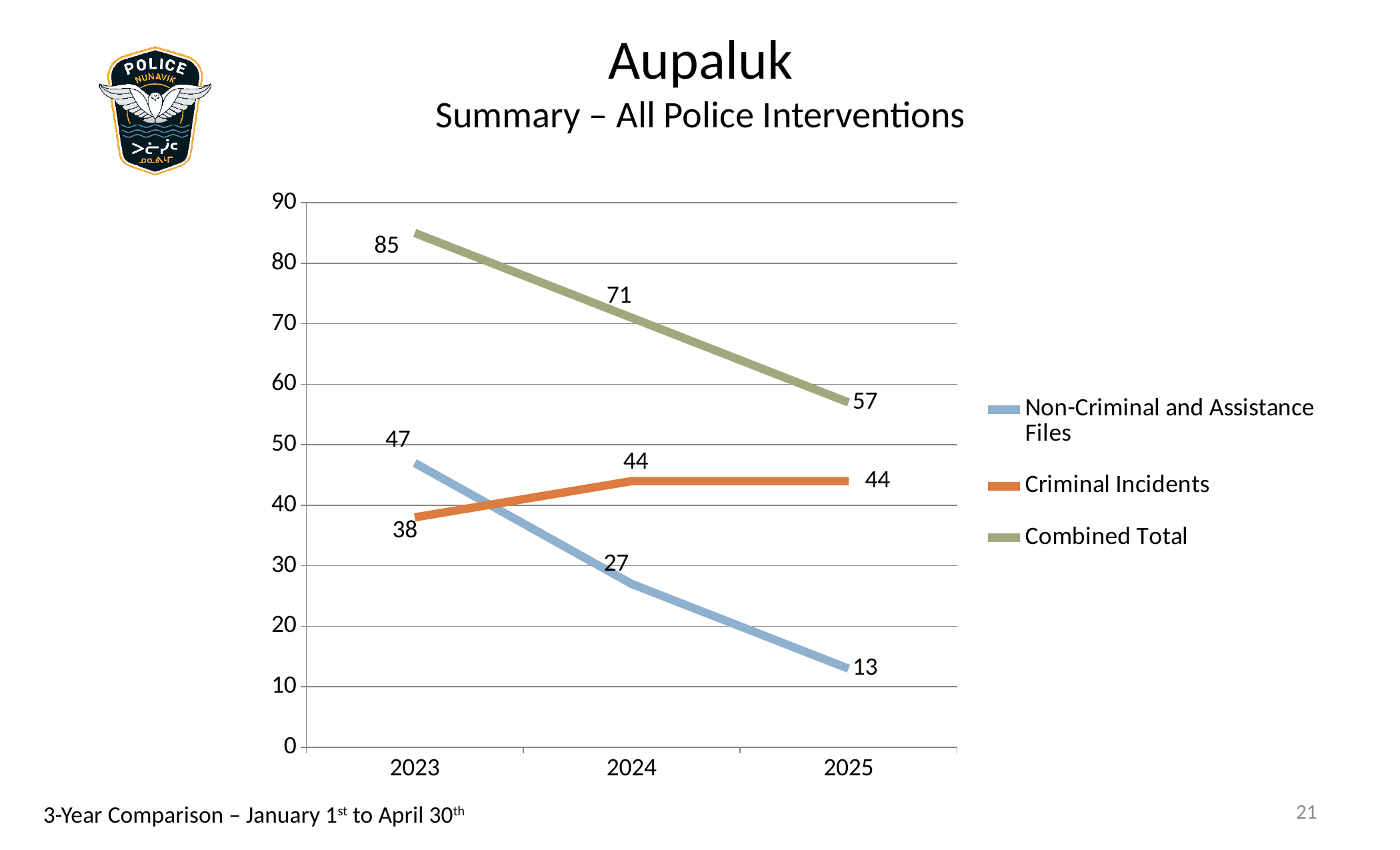
In which year is the value for Non-Criminal and Assistance Files lowest? 2025 Do the values for Non-Criminal and Assistance Files rise or fall from 2023 to 2025? Fall How many series does the legend list? 3 What kind of chart is shown on the slide? Line chart Which is larger in 2025: Criminal Incidents or Non-Criminal and Assistance Files? Criminal Incidents What is the value for Non-Criminal and Assistance Files in 2023? 47 What is the Combined Total for 2025? 57 What is the value for Criminal Incidents in 2024? 44 How many years are shown on the x axis? 3 What is the difference between the Combined Total in 2023 and in 2025? 28 In which year is the Combined Total highest? 2023 Is the Combined Total for 2024 greater or less than 60? greater